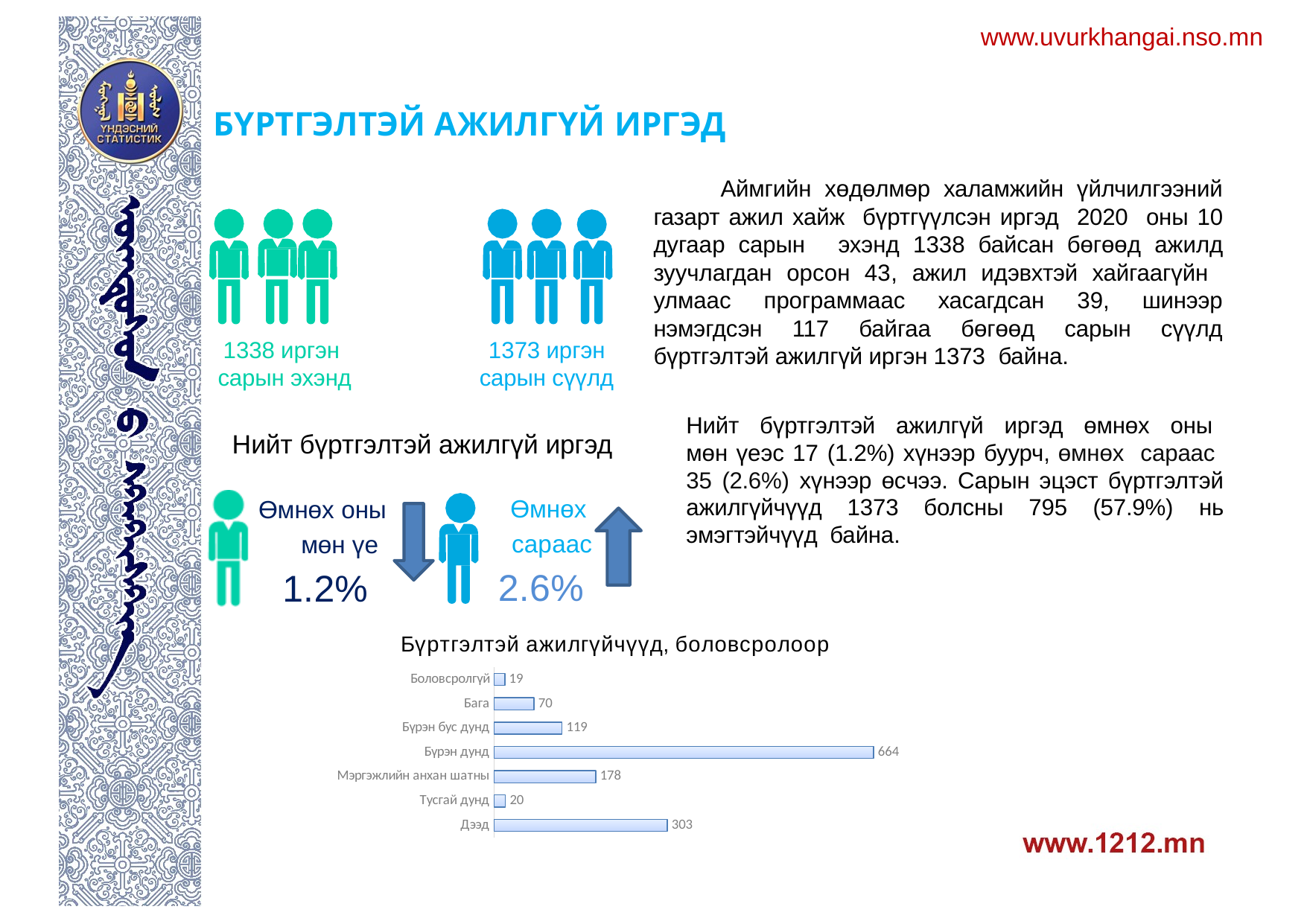
In the chart 'Бүртгэлтэй ажилгүйчүүд, боловсролоор', what is the difference between the values for Бүрэн дунд and Дээд? 361 What is the value for Бүрэн дунд in the chart 'Бүртгэлтэй ажилгүйчүүд, боловсролоор'? 664 What kind of chart is 'Бүртгэлтэй ажилгүйчүүд, боловсролоор'? Bar chart In the chart 'Бүртгэлтэй ажилгүйчүүд, боловсролоор', which is larger: the value for Мэргэжлийн анхан шатны or the value for Бүрэн бус дунд? Мэргэжлийн анхан шатны In the chart 'Бүртгэлтэй ажилгүйчүүд, боловсролоор', what is the difference between the values for Бүрэн бус дунд and Бага? 49 What is the value for Дээд in the chart 'Бүртгэлтэй ажилгүйчүүд, боловсролоор'? 303 Which category has the highest value in the chart 'Бүртгэлтэй ажилгүйчүүд, боловсролоор'? Бүрэн дунд What is the title of the bar chart at the bottom of the slide? Бүртгэлтэй ажилгүйчүүд, боловсролоор How many categories are shown in the chart 'Бүртгэлтэй ажилгүйчүүд, боловсролоор'? 7 What is the value for Мэргэжлийн анхан шатны in the chart 'Бүртгэлтэй ажилгүйчүүд, боловсролоор'? 178 Which category has the lowest value in the chart 'Бүртгэлтэй ажилгүйчүүд, боловсролоор'? Боловсролгүй What is the value for Боловсролгүй in the chart 'Бүртгэлтэй ажилгүйчүүд, боловсролоор'? 19